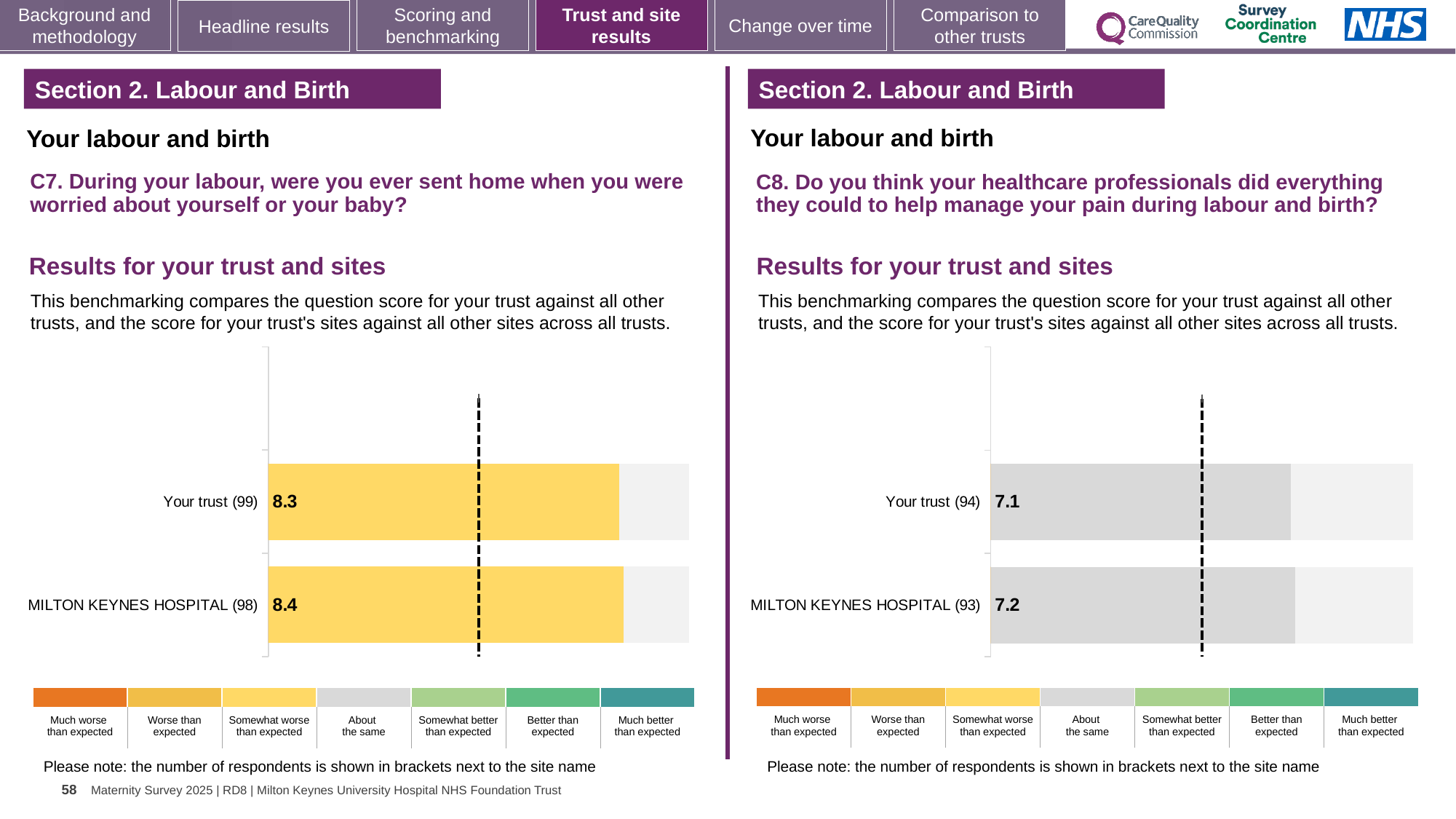
In the C8 chart on the right, what is the difference between the MILTON KEYNES HOSPITAL score and the Your trust score? 0.1 In the C8 chart on the right, what is the score for Your trust? 7.1 In the C8 chart on the right, how many respondents are shown in brackets for Your trust? 94 How many bars are plotted in the C7 chart on the left? 2 In the C7 chart on the left, what is the difference between the MILTON KEYNES HOSPITAL score and the Your trust score? 0.1 What kind of chart is used in the C8 chart on the right? Bar chart In the C8 chart on the right, which has the lower score, Your trust or MILTON KEYNES HOSPITAL? Your trust In the C7 chart on the left, what is the score for Your trust? 8.3 In the C7 chart on the left, what is the score for MILTON KEYNES HOSPITAL? 8.4 In the C8 chart on the right, what is the score for MILTON KEYNES HOSPITAL? 7.2 In the C7 chart on the left, which has the higher score, Your trust or MILTON KEYNES HOSPITAL? MILTON KEYNES HOSPITAL In the C7 chart on the left, how many respondents are shown in brackets for MILTON KEYNES HOSPITAL? 98